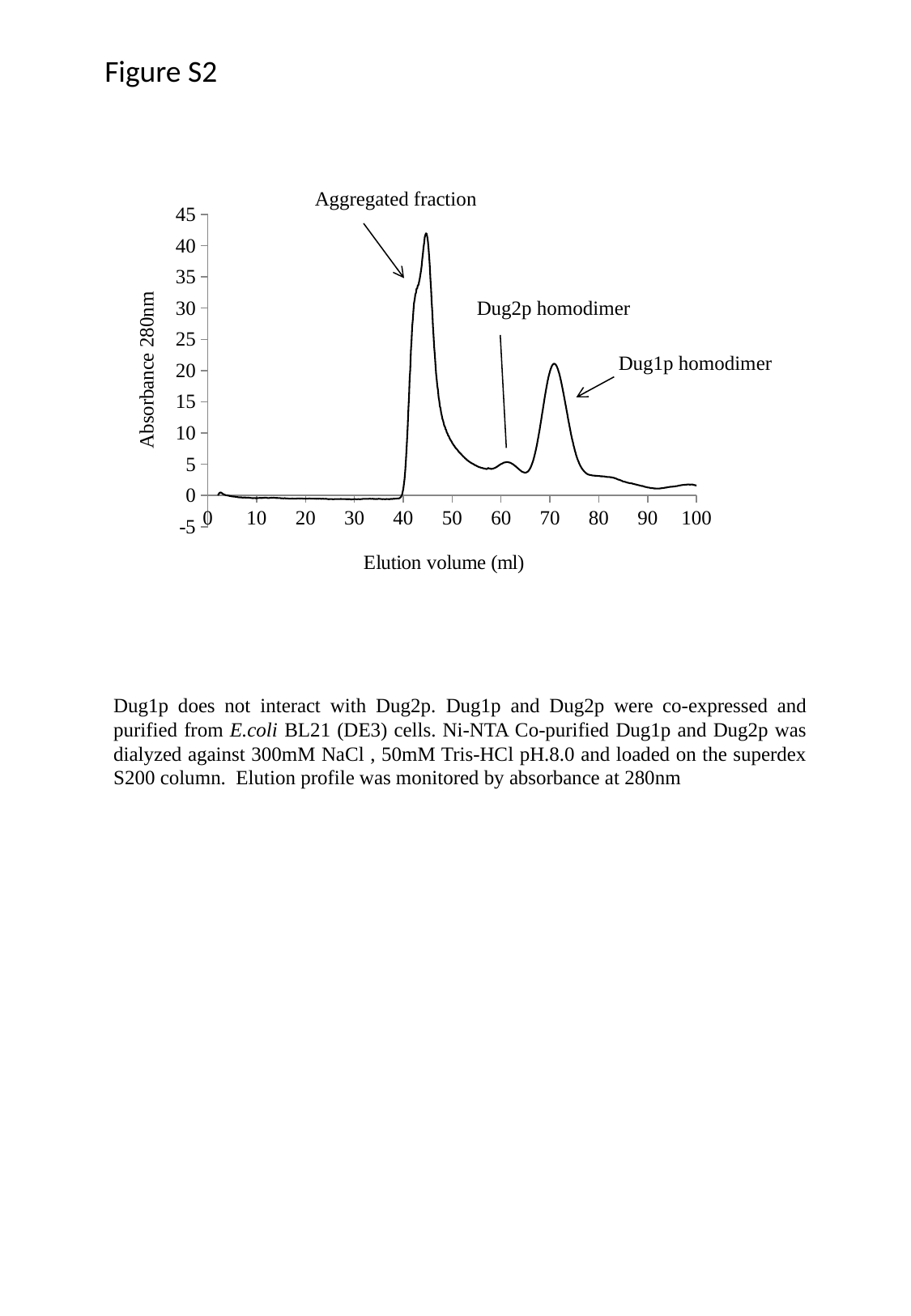
Between elution volumes of 45 ml and 60 ml, does the absorbance rise or fall? fall Which labeled peak has the lowest absorbance? Dug2p homodimer Which peak is higher, the aggregated fraction or the Dug1p homodimer? Aggregated fraction What is the label of the x axis? Elution volume (ml) Is the peak absorbance of the Dug2p homodimer greater or less than 10? less Is the peak absorbance of the aggregated fraction greater or less than 40? greater Which peak is higher, the Dug1p homodimer or the Dug2p homodimer? Dug1p homodimer Which labeled peak has the highest absorbance? Aggregated fraction Is the absorbance at an elution volume of 20 ml greater or less than 5? less How many labeled peaks are annotated on the chart? 3 What kind of chart is shown on the slide? line chart